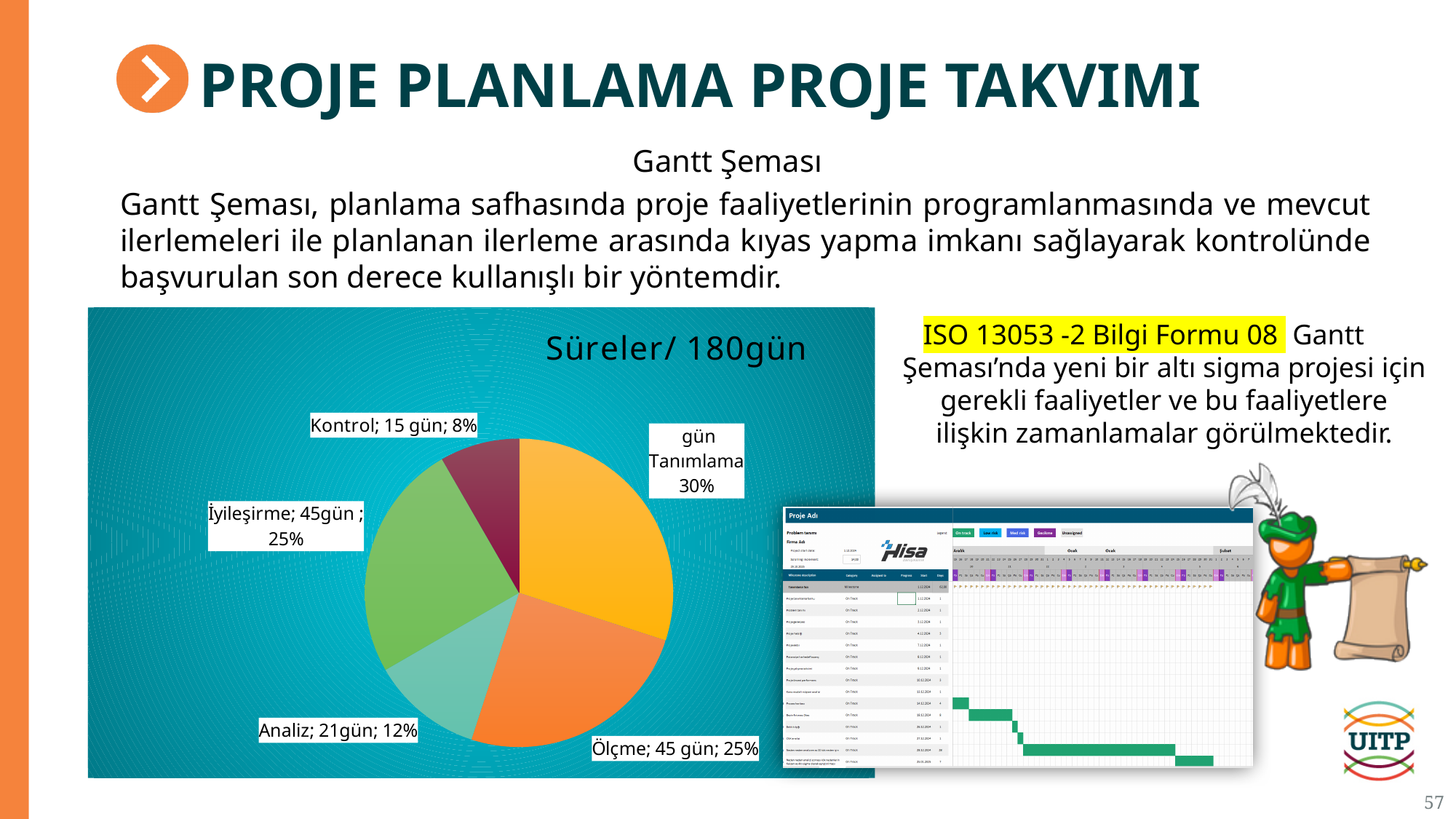
What kind of chart is shown under the title "Süreler/ 180gün"? Pie chart How many days are shown for Ölçme in the pie chart? 45 gün Which slice of the pie chart is the largest? Tanımlama What is the difference in days between Ölçme and Analiz in the pie chart? 24 gün How many days are shown for Kontrol in the pie chart? 15 gün Which slice of the pie chart is the smallest? Kontrol What share of the pie chart does İyileşirme take? 25% What is the title of the pie chart on the slide? Süreler/ 180gün How many days are shown for Analiz in the pie chart? 21gün Which has more days in the pie chart, İyileşirme or Kontrol? İyileşirme How many slices does the pie chart have? 5 What share of the pie chart does Tanımlama take? 30%